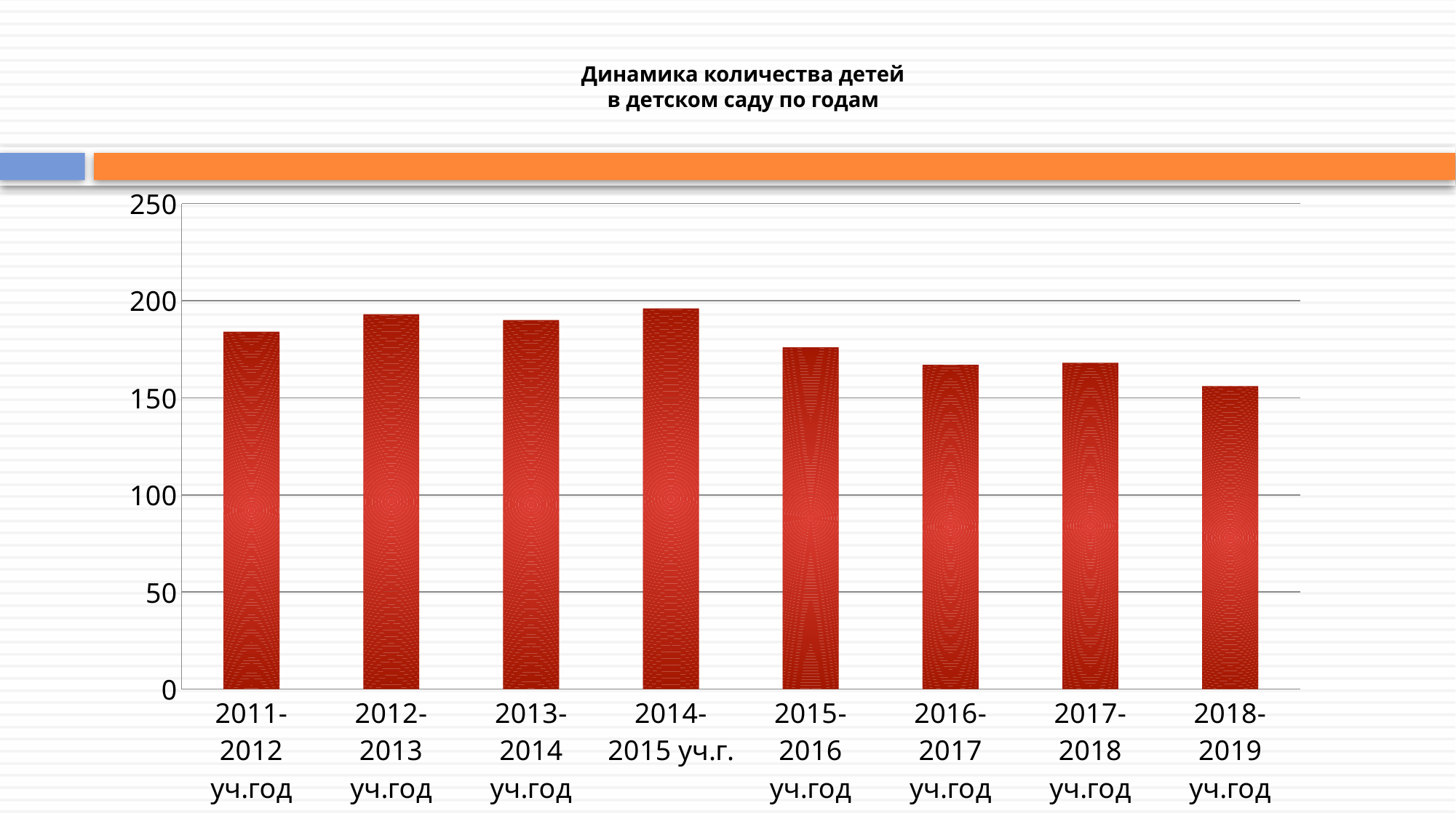
Which is larger, the value for 2011-2012 уч.год or the value for 2018-2019 уч.год? 2011-2012 уч.год Overall, do the values rise or fall from 2011-2012 to 2018-2019? fall Is the value for 2011-2012 уч.год greater or less than 150? greater What colour are the bars in the chart? red Is the value for 2016-2017 уч.год greater or less than 200? less What kind of chart is shown on the slide? bar chart Which academic year has the lowest number of children? 2018-2019 уч.год How many academic years (categories) are shown on the x axis? 8 What is the title of the chart? Динамика количества детей в детском саду по годам Which is larger, the value for 2015-2016 уч.год or the value for 2016-2017 уч.год? 2015-2016 уч.год Is the value for 2014-2015 уч.г. greater or less than 200? less